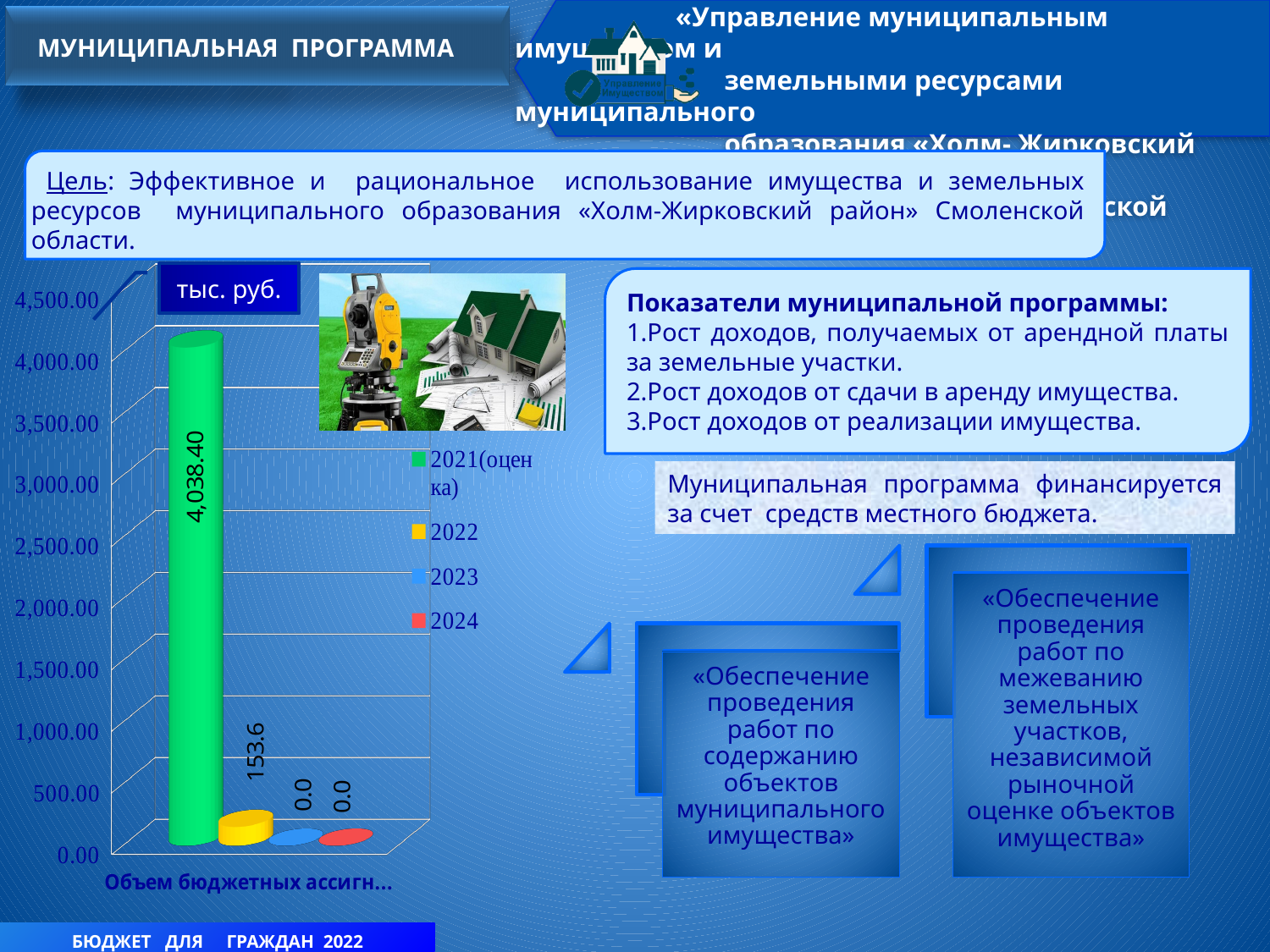
Which is larger, the value for 2022 or the value for 2023? 2022 Is the value for 2021(оценка) greater or less than 4,000.00? greater What is the difference between the 2021(оценка) value and the 2022 value? 3,884.80 Which series has the highest value in the chart? 2021(оценка) What unit is shown in the label above the chart? тыс. руб. What is the value for the 2024 series in the chart? 0.0 How many series does the chart legend list? 4 What is the value for the 2021(оценка) series in the chart? 4,038.40 What kind of chart is shown on the slide? bar chart What is the value for the 2022 series in the chart? 153.6 What is the value for the 2023 series in the chart? 0.0 Is the value for 2022 greater or less than 500.00? less